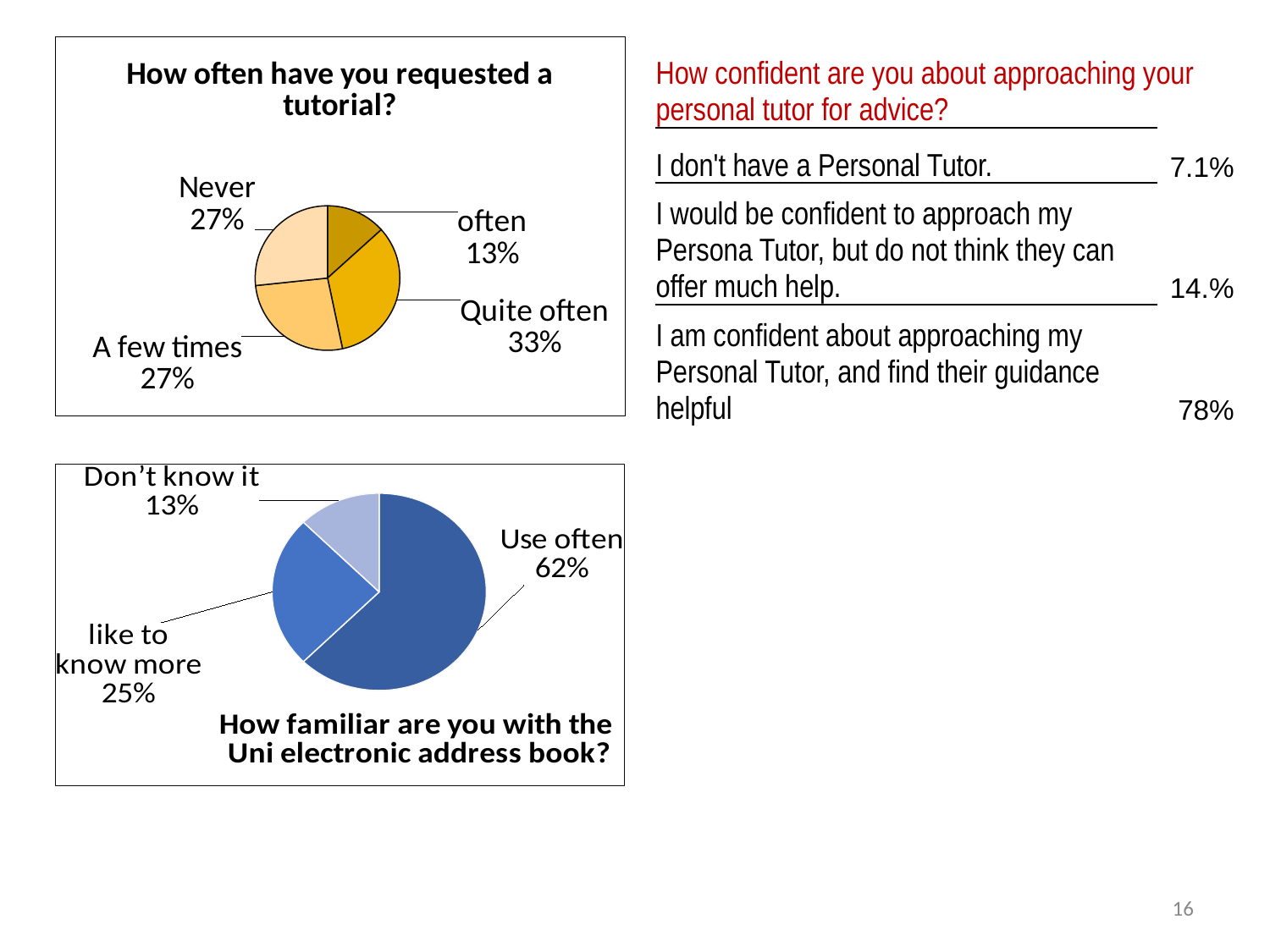
In the chart titled "How familiar are you with the Uni electronic address book?", what percentage of respondents answered "Use often"? 62% What type of chart is the one titled "How often have you requested a tutorial?"? Pie chart In the chart titled "How often have you requested a tutorial?", what percentage of respondents answered "Quite often"? 33% In the chart titled "How familiar are you with the Uni electronic address book?", which is larger: "like to know more" or "Don't know it"? like to know more In the chart titled "How often have you requested a tutorial?", what percentage of respondents answered "Never"? 27% In the chart titled "How often have you requested a tutorial?", which category has the largest share? Quite often In the chart titled "How familiar are you with the Uni electronic address book?", what percentage of respondents answered "like to know more"? 25% In the chart titled "How often have you requested a tutorial?", how many categories are shown? 4 In the chart titled "How familiar are you with the Uni electronic address book?", which category has the smallest share? Don't know it In the chart titled "How often have you requested a tutorial?", which category has the smallest share? often In the chart titled "How familiar are you with the Uni electronic address book?", how many categories are shown? 3 In the chart titled "How often have you requested a tutorial?", what is the difference in percentage points between "Quite often" and "often"? 20